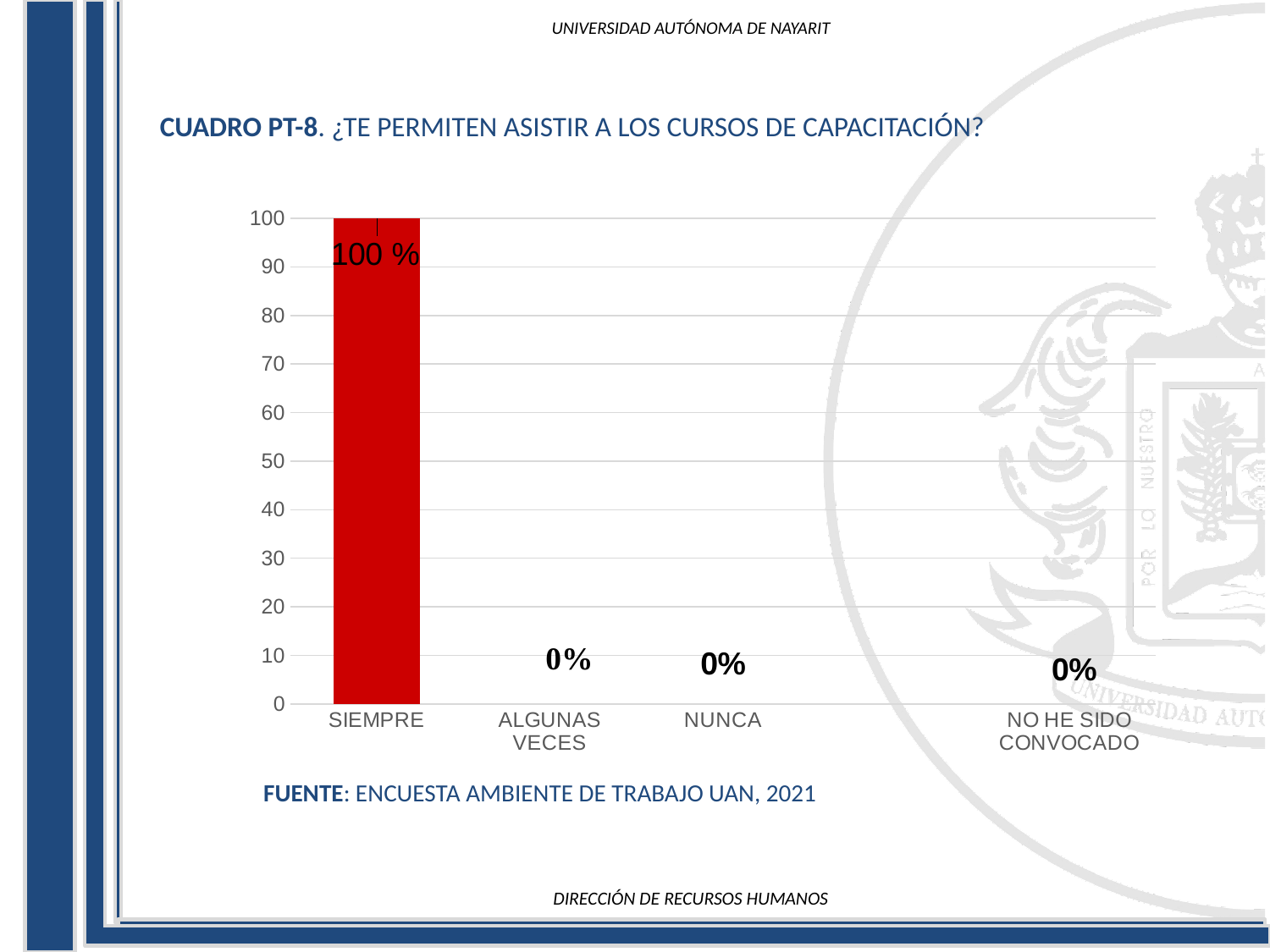
What is the value shown for NO HE SIDO CONVOCADO? 0% What is the value shown for SIEMPRE? 100 % How many categories are shown on the x axis? 4 Which category has the highest value? SIEMPRE What is the title of the chart? CUADRO PT-8. ¿TE PERMITEN ASISTIR A LOS CURSOS DE CAPACITACIÓN? What is the value shown for ALGUNAS VECES? 0% What colour is the bar for SIEMPRE? red Is the value for SIEMPRE greater or less than 50? greater Which is larger, the value for SIEMPRE or the value for ALGUNAS VECES? SIEMPRE What is the value shown for NUNCA? 0% What is the difference between the values for SIEMPRE and NUNCA? 100 % What kind of chart is shown on the slide? bar chart